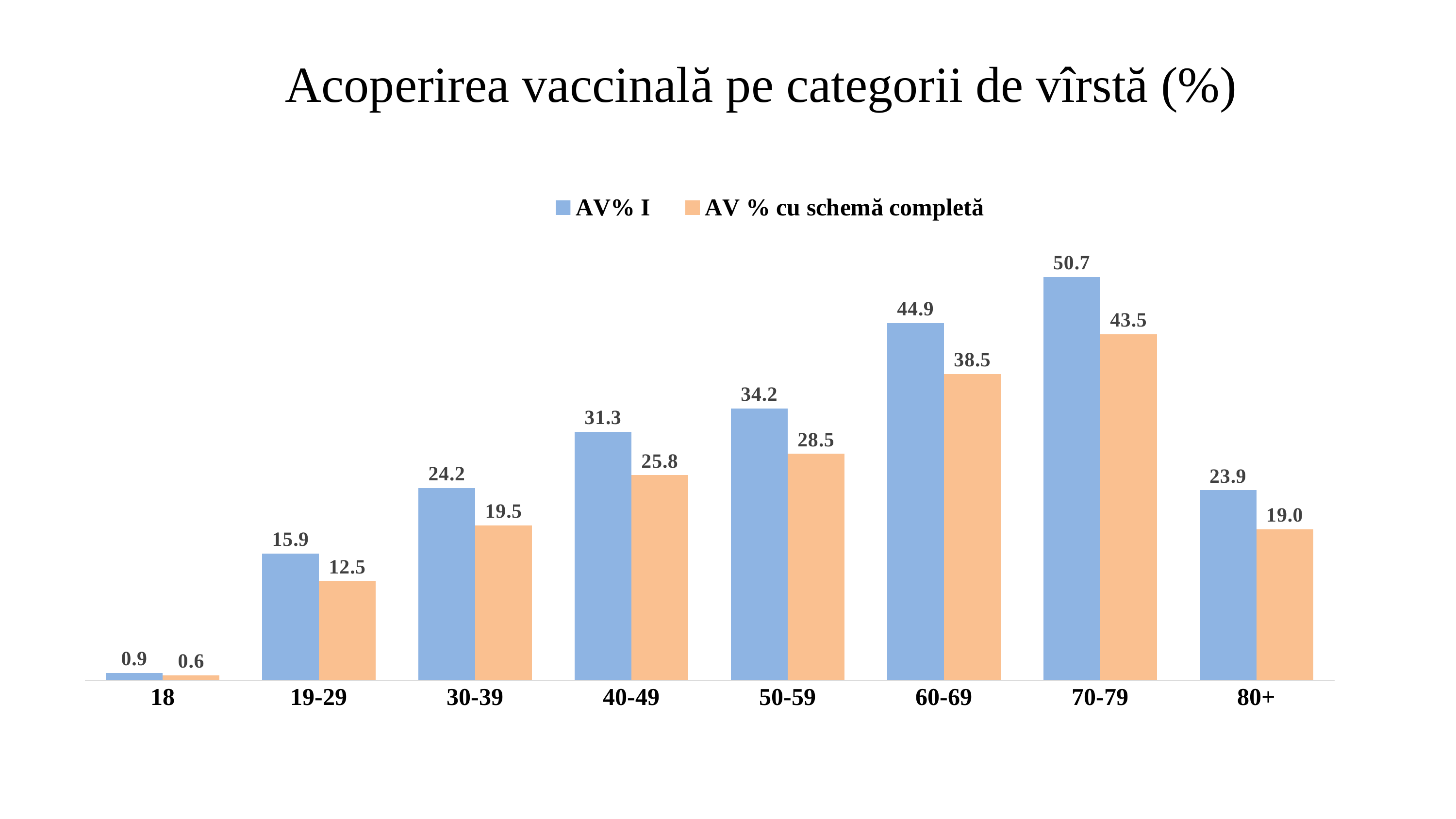
What is the title of the chart? Acoperirea vaccinală pe categorii de vîrstă (%) What is the AV% I value for the 40-49 age group? 31.3 How many age categories are shown on the x axis? 8 What is the AV % cu schemă completă value for the 80+ age group? 19.0 What is the difference in AV% I between the 60-69 and 50-59 age groups? 10.7 Which age group has the highest AV% I value? 70-79 What kind of chart is shown on the slide? Bar chart How many series does the legend list? 2 What is the AV % cu schemă completă value for the 60-69 age group? 38.5 Which is larger: the AV% I value for 30-39 or the AV% I value for 80+? 30-39 Which age group has the lowest AV % cu schemă completă value? 18 What is the difference between AV% I and AV % cu schemă completă for the 70-79 age group? 7.2